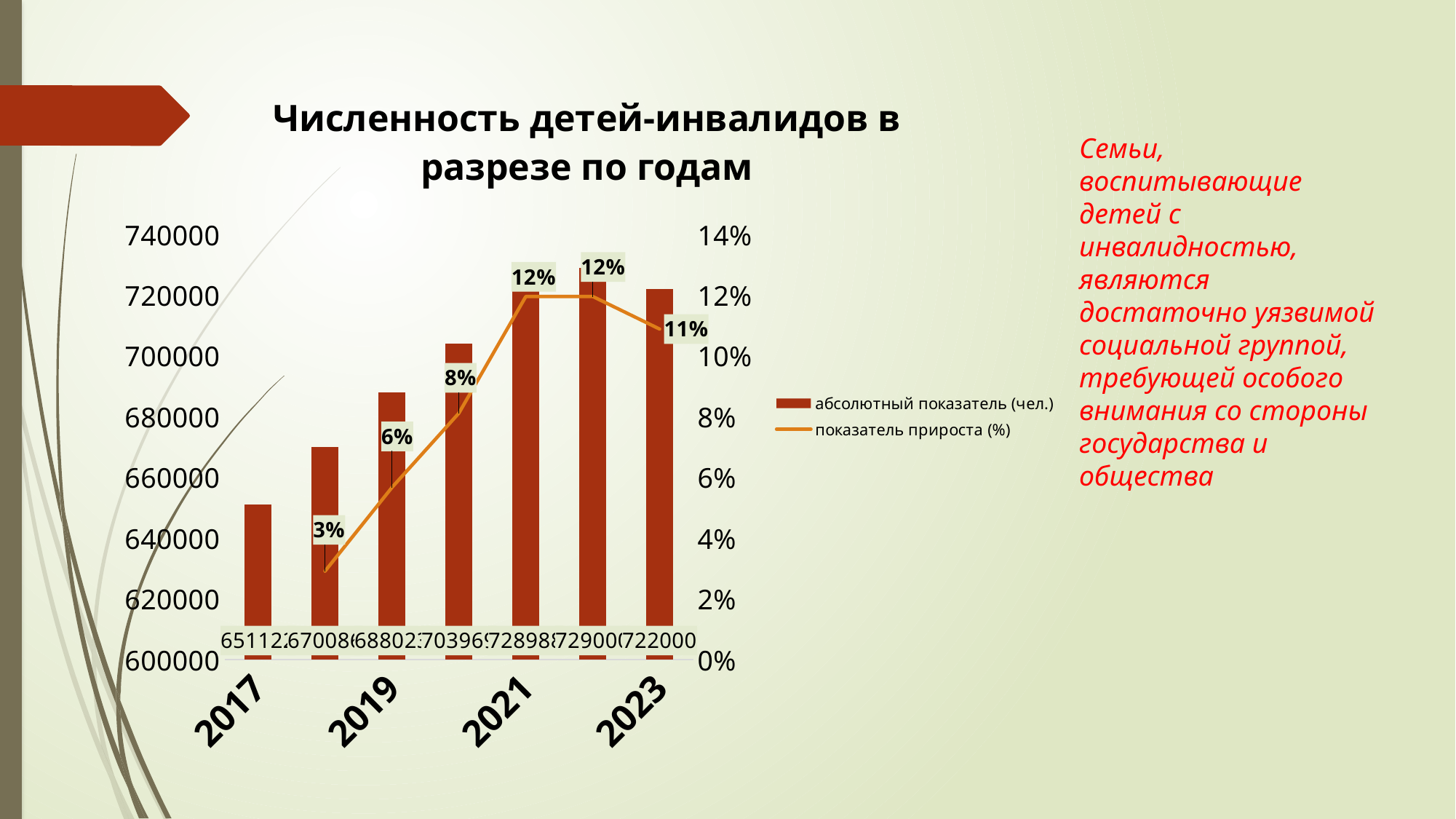
How many bars are plotted in the chart? 7 Which year has the higher growth rate, 2021 or 2023? 2021 What is the growth rate (показатель прироста) shown for 2021? 12% Is the absolute number for 2017 greater or less than 660000? less What is the title of the chart? Численность детей-инвалидов в разрезе по годам Which year has the lowest bar for the absolute number of children? 2017 How many series does the chart legend list? 2 What is the growth rate (показатель прироста) shown for 2019? 6% What is the growth rate (показатель прироста) shown for 2023? 11% Is the absolute number for 2021 greater or less than 720000? greater By how many percentage points does the growth rate for 2021 exceed that for 2019? 6 What kind of chart is used for the series 'абсолютный показатель (чел.)'? bar chart